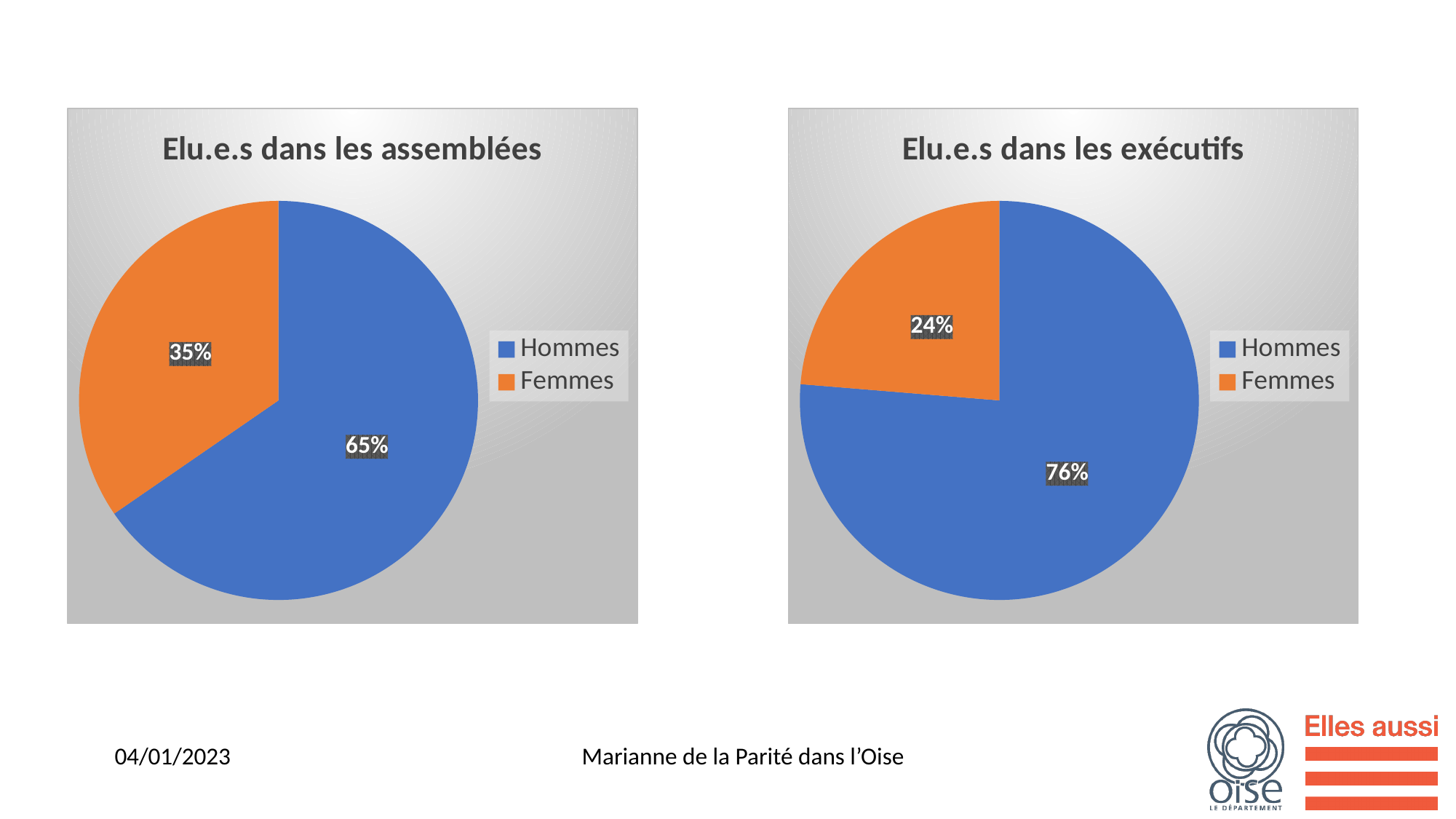
In the chart titled "Elu.e.s dans les assemblées", what is the difference between the Hommes and Femmes shares? 30% In the chart titled "Elu.e.s dans les assemblées", what share of the pie is Femmes? 35% In the chart titled "Elu.e.s dans les exécutifs", what colour is the Femmes slice? Orange In the chart titled "Elu.e.s dans les assemblées", which category has the largest slice? Hommes In the chart titled "Elu.e.s dans les exécutifs", which category has the smallest slice? Femmes How many categories does the chart titled "Elu.e.s dans les assemblées" show? 2 In the chart titled "Elu.e.s dans les exécutifs", what share of the pie is Hommes? 76% In the chart titled "Elu.e.s dans les exécutifs", what share of the pie is Femmes? 24% What kind of chart is the chart titled "Elu.e.s dans les exécutifs"? Pie chart In the chart titled "Elu.e.s dans les exécutifs", what is the difference between the Hommes and Femmes shares? 52% Is the Femmes share larger in the chart titled "Elu.e.s dans les assemblées" or in the chart titled "Elu.e.s dans les exécutifs"? Elu.e.s dans les assemblées